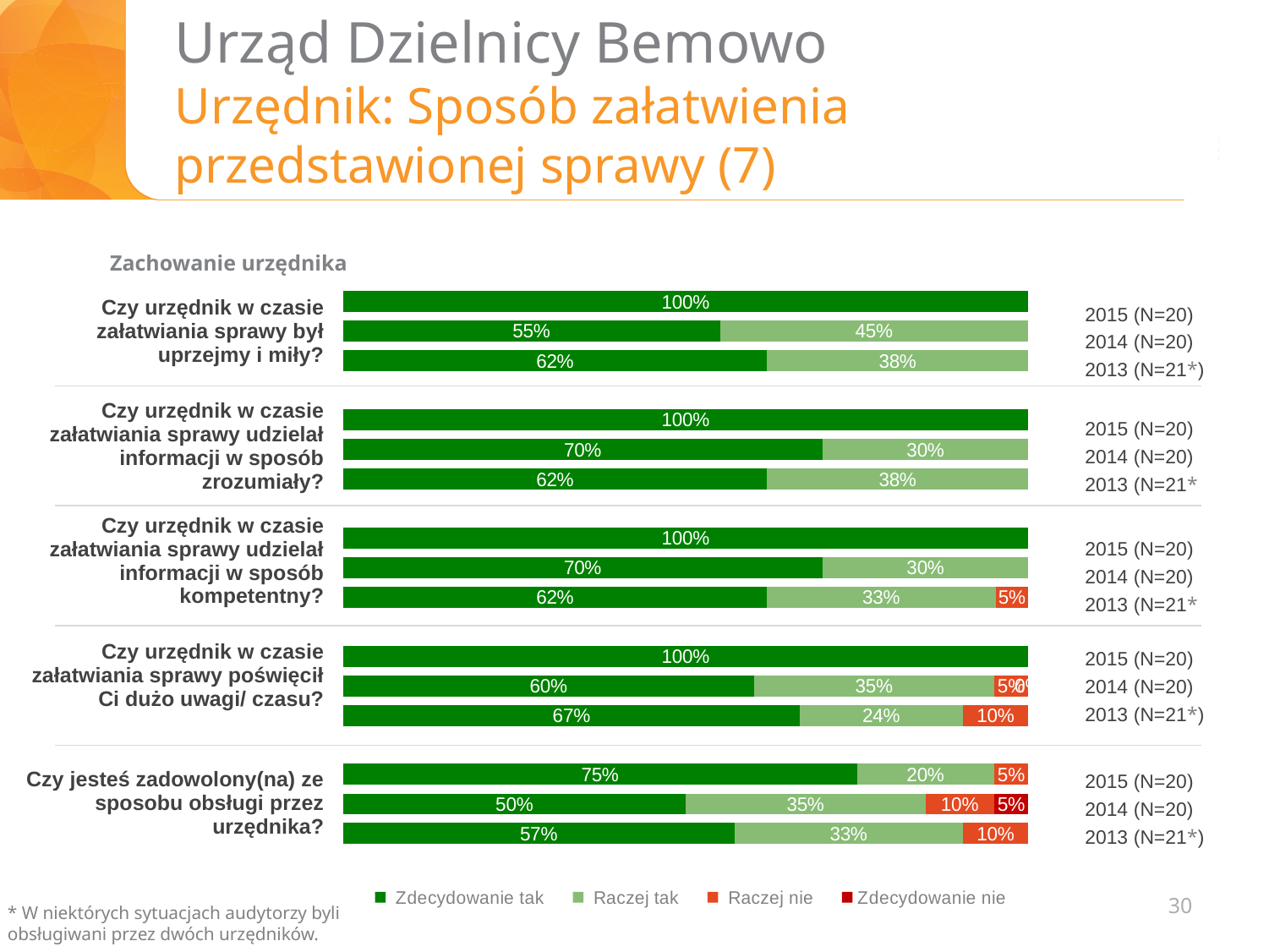
In the chart for "Czy jesteś zadowolony(na) ze sposobu obsługi przez urzędnika?", what is the difference between the "Zdecydowanie tak" values for 2015 (N=20) and 2014 (N=20)? 25% What kind of chart is used on this slide? Stacked bar chart In the chart for "Czy urzędnik w czasie załatwiania sprawy był uprzejmy i miły?", what is the "Raczej tak" value for 2013 (N=21*)? 38% In the chart for "Czy urzędnik w czasie załatwiania sprawy był uprzejmy i miły?", what is the "Zdecydowanie tak" value for 2014 (N=20)? 55% In the chart for "Czy urzędnik w czasie załatwiania sprawy udzielał informacji w sposób kompetentny?", what is the "Raczej nie" value for 2013 (N=21*)? 5% In the chart for "Czy urzędnik w czasie załatwiania sprawy był uprzejmy i miły?", which is larger: the "Zdecydowanie tak" value for 2014 (N=20) or for 2013 (N=21*)? 2013 (N=21*) In the chart for "Czy urzędnik w czasie załatwiania sprawy poświęcił Ci dużo uwagi/ czasu?", what is the "Raczej tak" value for 2013 (N=21*)? 24% In the chart for "Czy jesteś zadowolony(na) ze sposobu obsługi przez urzędnika?", what is the "Zdecydowanie nie" value for 2014 (N=20)? 5% In the chart for "Czy urzędnik w czasie załatwiania sprawy udzielał informacji w sposób zrozumiały?", what is the "Zdecydowanie tak" value for 2014 (N=20)? 70% In the chart for "Czy jesteś zadowolony(na) ze sposobu obsługi przez urzędnika?", which year has the lowest "Zdecydowanie tak" value? 2014 (N=20) How many series does the legend list? 4 In the chart for "Czy jesteś zadowolony(na) ze sposobu obsługi przez urzędnika?", what is the "Zdecydowanie tak" value for 2015 (N=20)? 75%